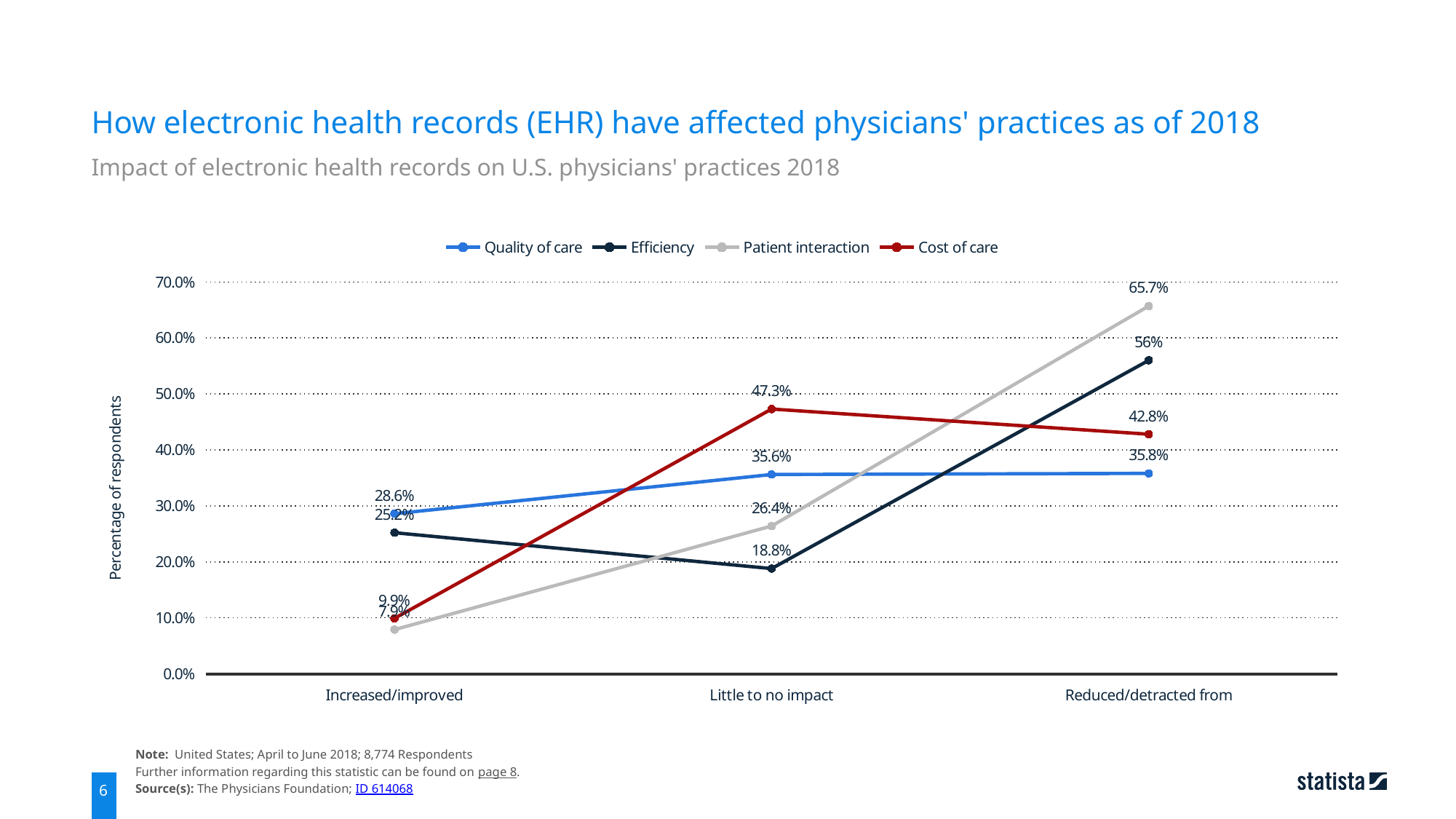
What is the value for Cost of care at Little to no impact? 47.3% At Increased/improved, which is larger: Quality of care or Efficiency? Quality of care Does the Patient interaction line rise or fall from Increased/improved to Reduced/detracted from? Rises Which series has the highest value at Reduced/detracted from? Patient interaction What kind of chart is shown on the slide? Line chart What is the value for Quality of care at Increased/improved? 28.6% What is the value for Patient interaction at Reduced/detracted from? 65.7% Which series has the lowest value at Little to no impact? Efficiency What is the difference between the Cost of care values at Little to no impact and Reduced/detracted from? 4.5 percentage points How many series does the legend list? 4 What is the value for Efficiency at Reduced/detracted from? 56% How many categories are shown on the x axis? 3